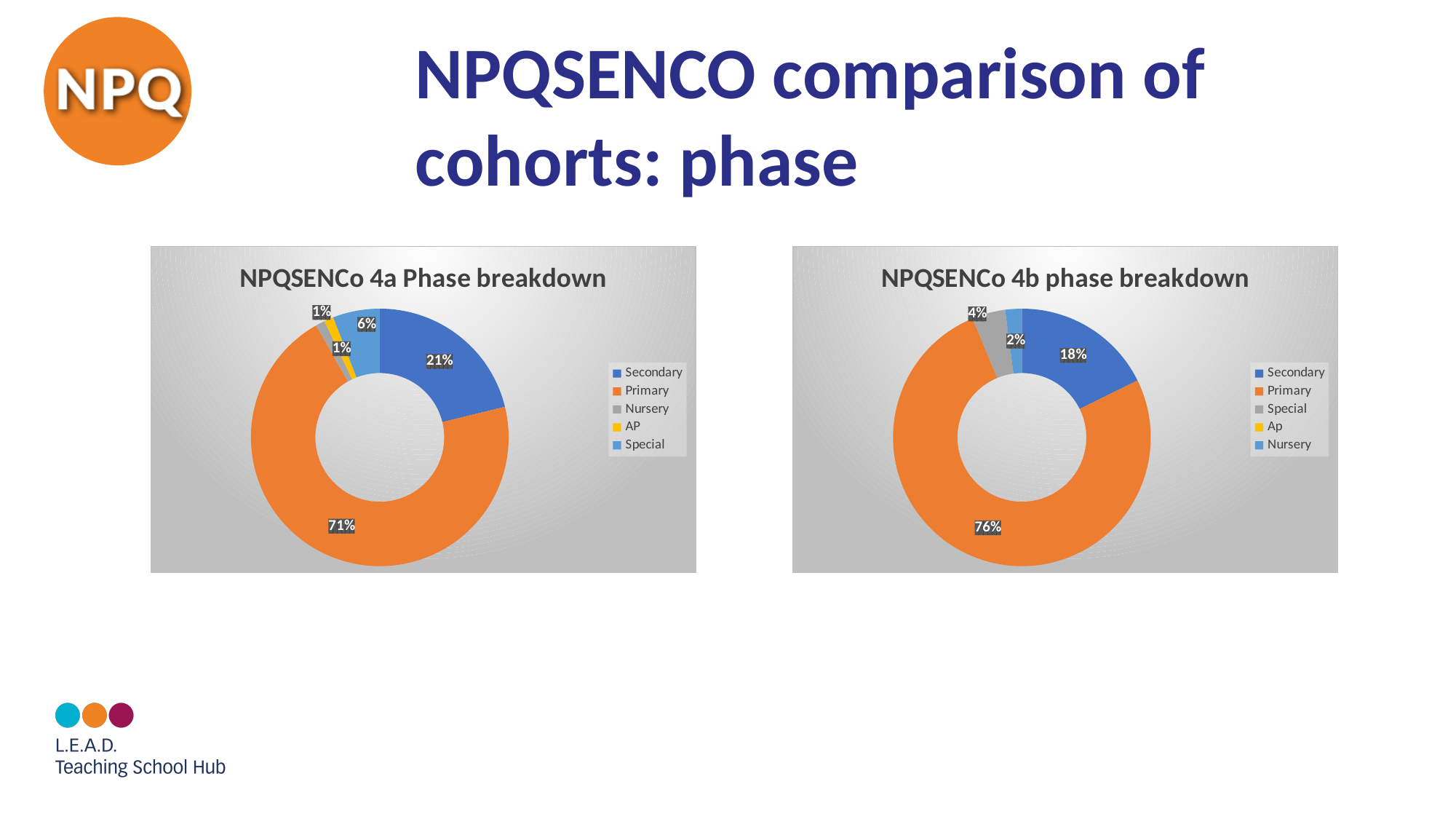
In the NPQSENCo 4a Phase breakdown chart, what percentage is shown for Special? 6% In the NPQSENCo 4a Phase breakdown chart, what percentage is shown for Secondary? 21% In the NPQSENCo 4b phase breakdown chart, which phase has the largest share? Primary Which chart shows a larger Secondary share, NPQSENCo 4a or NPQSENCo 4b? NPQSENCo 4a In the NPQSENCo 4b phase breakdown chart, what percentage is shown for Special? 4% In the NPQSENCo 4a Phase breakdown chart, what share of the cohort is Primary? 71% How many percentage points higher is the Primary share in the NPQSENCo 4b chart than in the NPQSENCo 4a chart? 5 percentage points In the NPQSENCo 4b phase breakdown chart, what percentage is shown for Nursery? 2% How many entries does the legend of the NPQSENCo 4a Phase breakdown chart list? 5 In the NPQSENCo 4a Phase breakdown chart, which phase has the largest share? Primary In the NPQSENCo 4b phase breakdown chart, what percentage is shown for Secondary? 18% In the NPQSENCo 4b phase breakdown chart, what share of the cohort is Primary? 76%